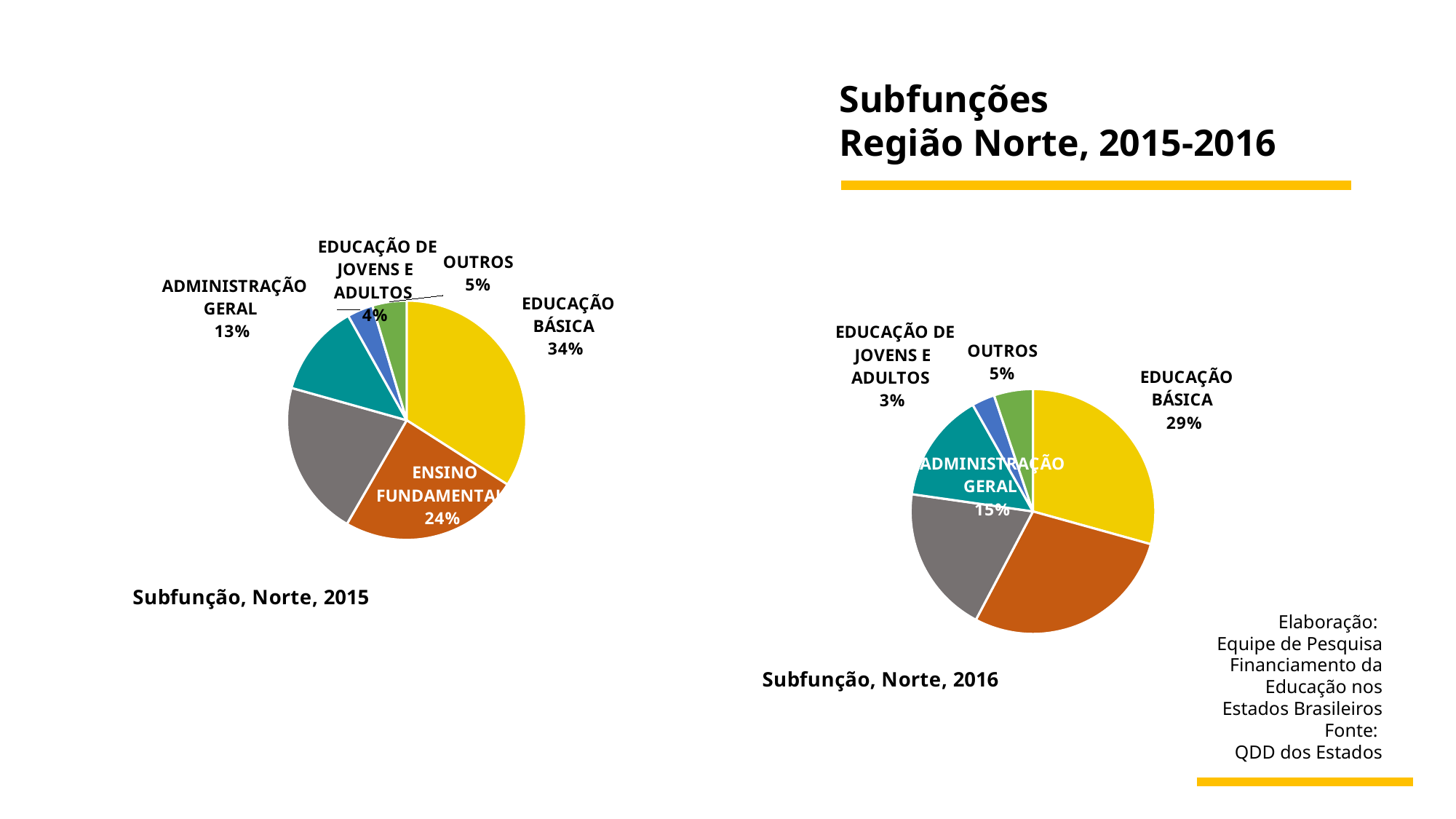
What type of chart is used for 'Subfunção, Norte, 2015'? Pie chart In the 'Subfunção, Norte, 2015' pie chart, which labelled category has the smallest share? EDUCAÇÃO DE JOVENS E ADULTOS In the 'Subfunção, Norte, 2016' pie chart, what share does ADMINISTRAÇÃO GERAL have? 15% How many slices does the 'Subfunção, Norte, 2016' pie chart have? 6 In the 'Subfunção, Norte, 2016' pie chart, what share does EDUCAÇÃO BÁSICA have? 29% In the 'Subfunção, Norte, 2015' pie chart, what share does EDUCAÇÃO BÁSICA have? 34% In the 'Subfunção, Norte, 2015' pie chart, which labelled category has the largest share? EDUCAÇÃO BÁSICA Is the share of ADMINISTRAÇÃO GERAL larger in the 2015 pie chart or in the 2016 pie chart? 2016 In the 'Subfunção, Norte, 2015' pie chart, what share does ENSINO FUNDAMENTAL have? 24% In the 'Subfunção, Norte, 2016' pie chart, what share does EDUCAÇÃO DE JOVENS E ADULTOS have? 3% In the 'Subfunção, Norte, 2015' pie chart, how many percentage points larger is EDUCAÇÃO BÁSICA than ENSINO FUNDAMENTAL? 10 percentage points In the 'Subfunção, Norte, 2015' pie chart, what share does ADMINISTRAÇÃO GERAL have? 13%